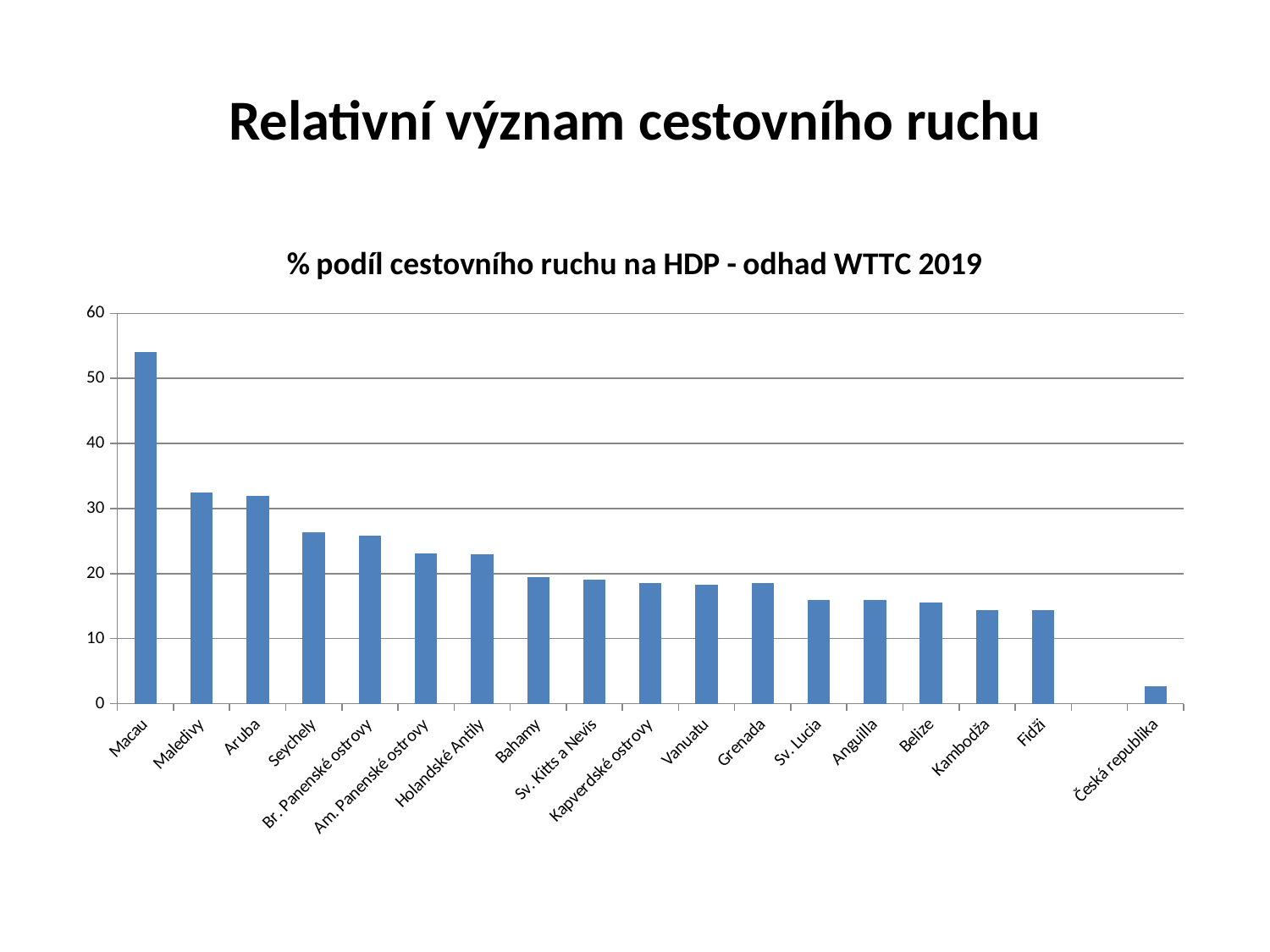
Is the value for Macau greater or less than 50? greater Is the value for Maledivy greater or less than 30? greater What is the title of the chart? % podíl cestovního ruchu na HDP - odhad WTTC 2019 Do the values generally rise or fall from left to right along the x axis? fall Which is larger, the value for Seychely or the value for Fidži? Seychely Which category has the highest value? Macau What kind of chart is shown on the slide? bar chart Which category has the lowest value? Česká republika Is the value for Seychely greater or less than 20? greater Which is larger, the value for Macau or the value for Maledivy? Macau